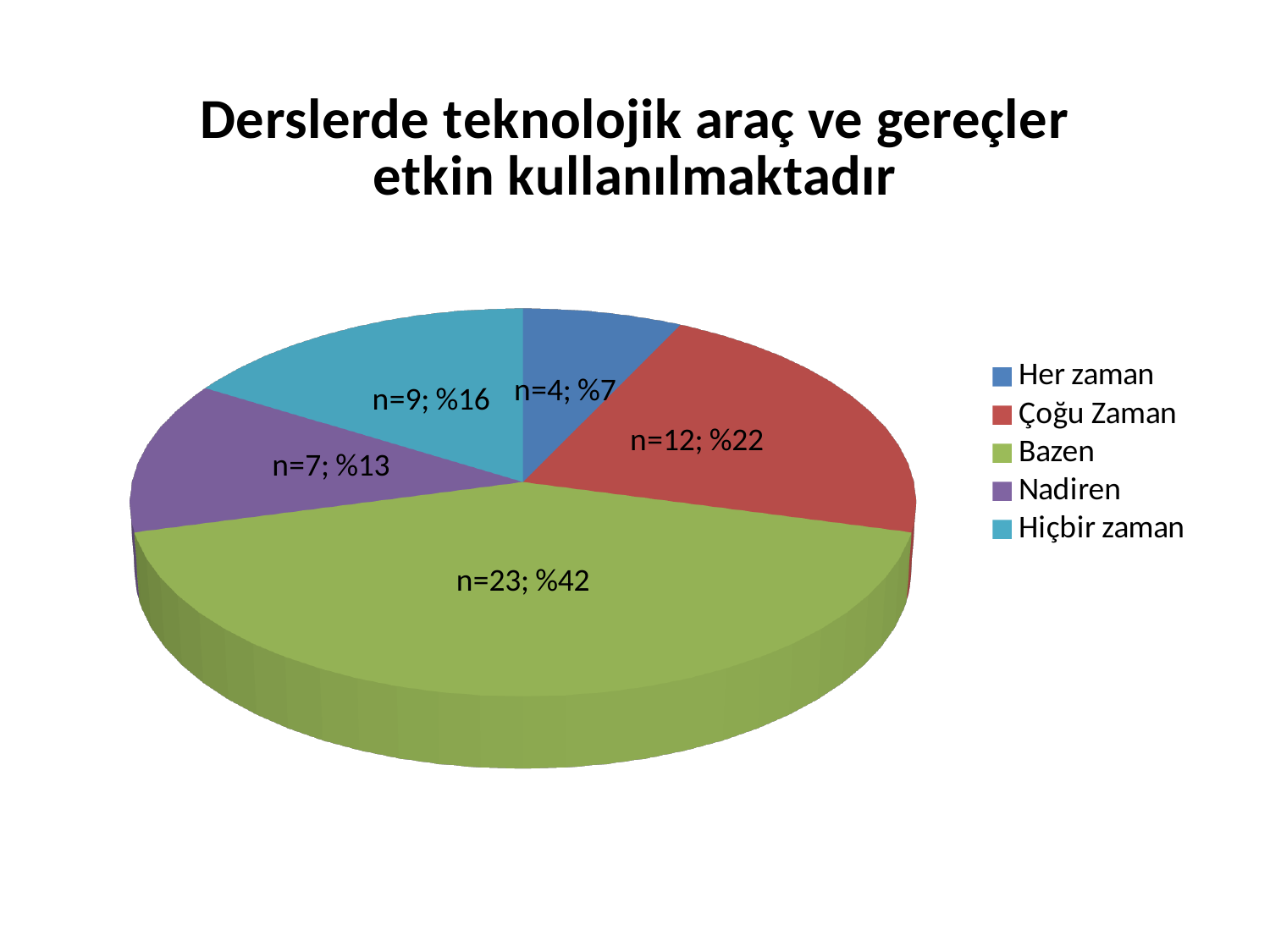
What is the count (n) for the 'Çoğu Zaman' slice? n=12 What is the difference in count (n) between 'Bazen' and 'Çoğu Zaman'? 11 What is the total count (n) across all slices? 55 What is the count (n) for the 'Bazen' slice? n=23 What percentage share does the 'Hiçbir zaman' slice have? %16 What is the title of the chart? Derslerde teknolojik araç ve gereçler etkin kullanılmaktadır Which category has the largest slice? Bazen Which category has the smallest slice? Her zaman How many slices does the pie chart have? 5 What percentage share does the 'Bazen' slice have? %42 Which has a larger count, 'Nadiren' or 'Hiçbir zaman'? Hiçbir zaman What kind of chart is shown on the slide? Pie chart